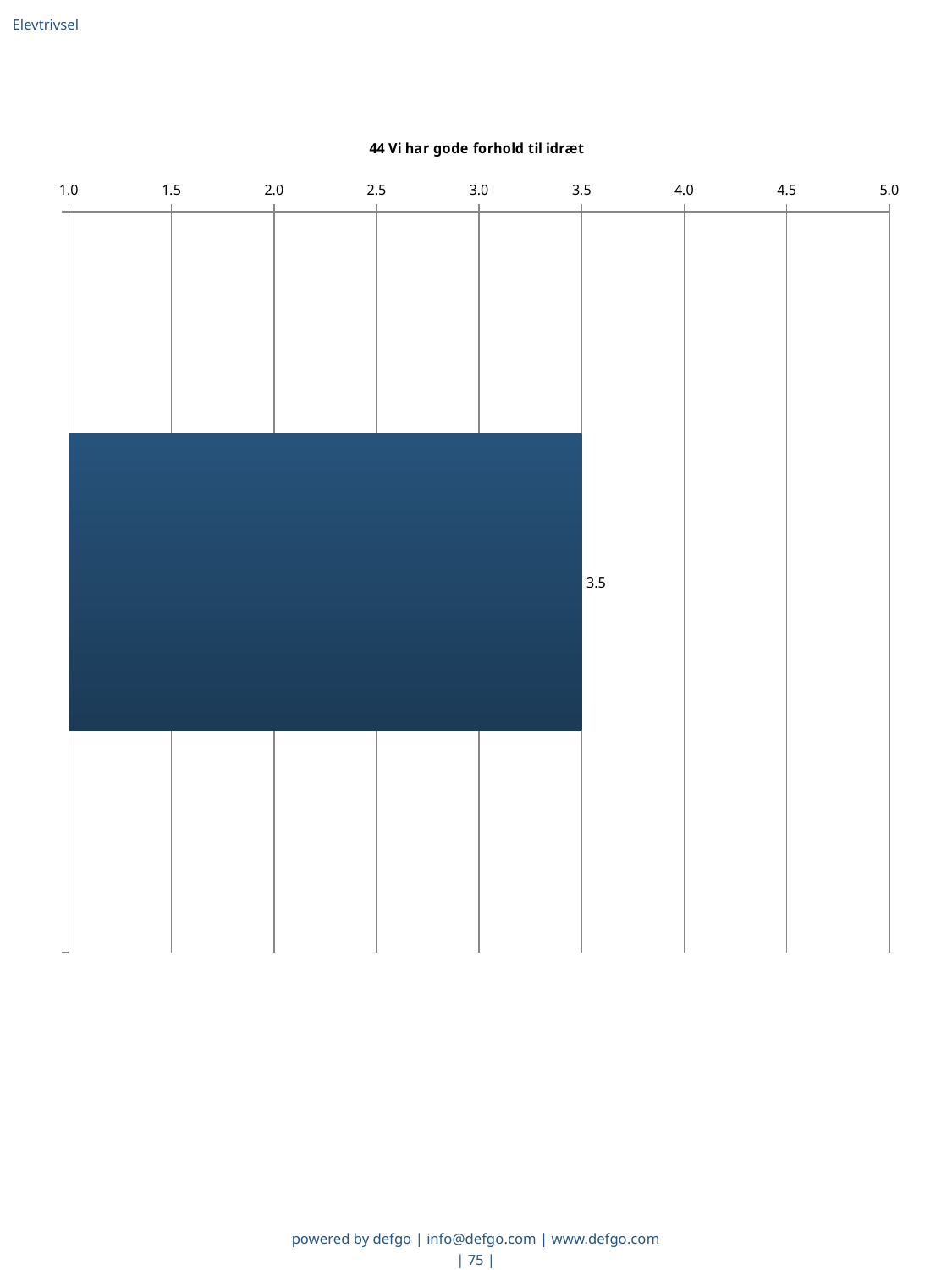
Is the value of the bar greater or less than 4.0? less What is the highest value shown on the chart's axis? 5.0 Is the value of the bar greater or less than 3.0? greater What is the value shown by the bar in the chart? 3.5 What is the title of the chart? 44 Vi har gode forhold til idræt What kind of chart is shown on the slide? bar chart How many bars are plotted in the chart? 1 What is the lowest value shown on the chart's axis? 1.0